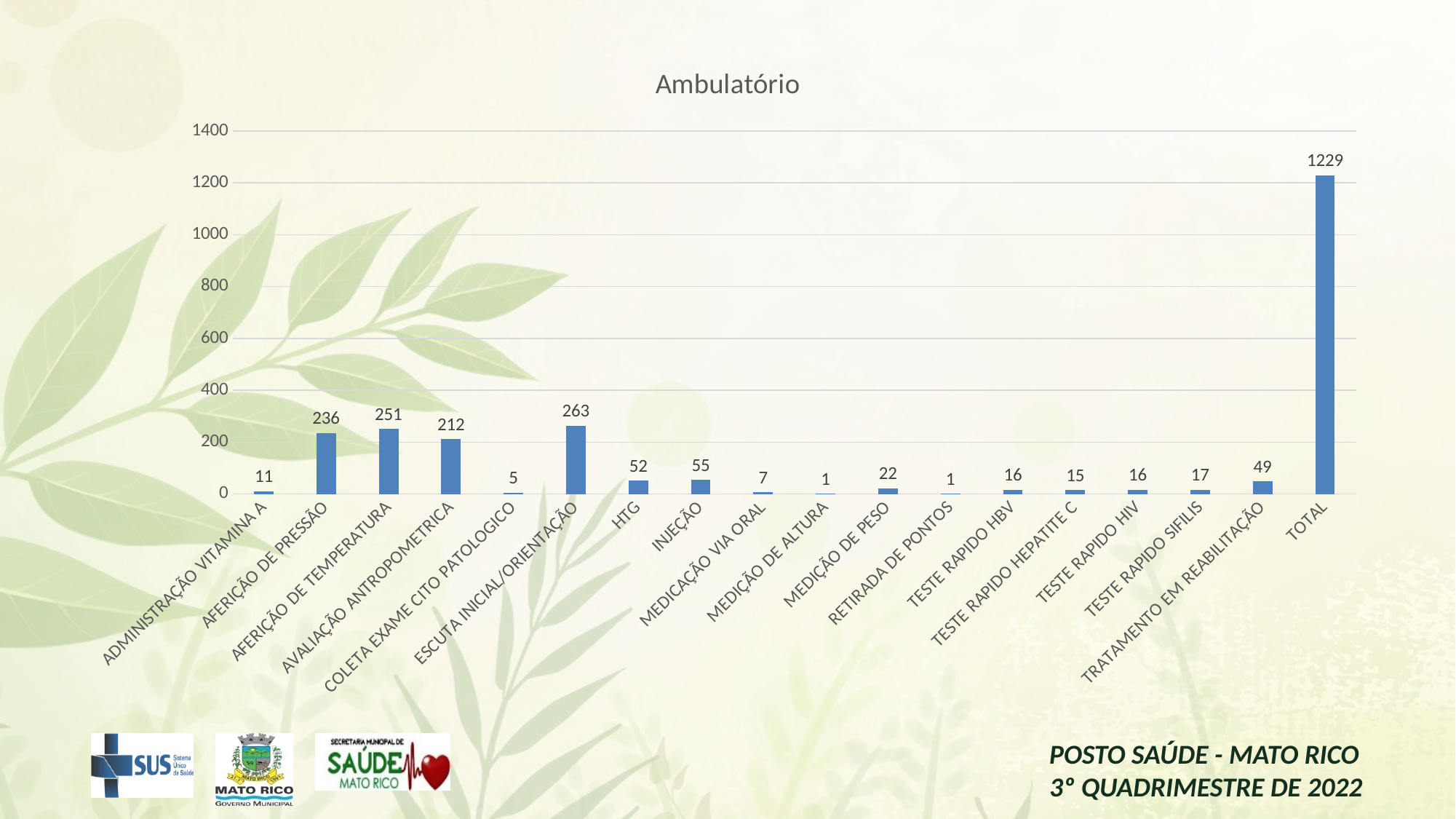
Which category has the highest value? TOTAL What is the value for TOTAL? 1229 What is the value for ESCUTA INICIAL/ORIENTAÇÃO? 263 Excluding TOTAL, which category has the highest value? ESCUTA INICIAL/ORIENTAÇÃO How many categories are shown on the x axis? 18 Is the value for TOTAL greater or less than 1200? greater What type of chart is shown on the slide? bar chart Which is larger, HTG or INJEÇÃO? INJEÇÃO What is the value for AFERIÇÃO DE PRESSÃO? 236 What is the difference between AFERIÇÃO DE TEMPERATURA and AVALIAÇÃO ANTROPOMETRICA? 39 What is the title of the chart? Ambulatório What is the value for TRATAMENTO EM REABILITAÇÃO? 49